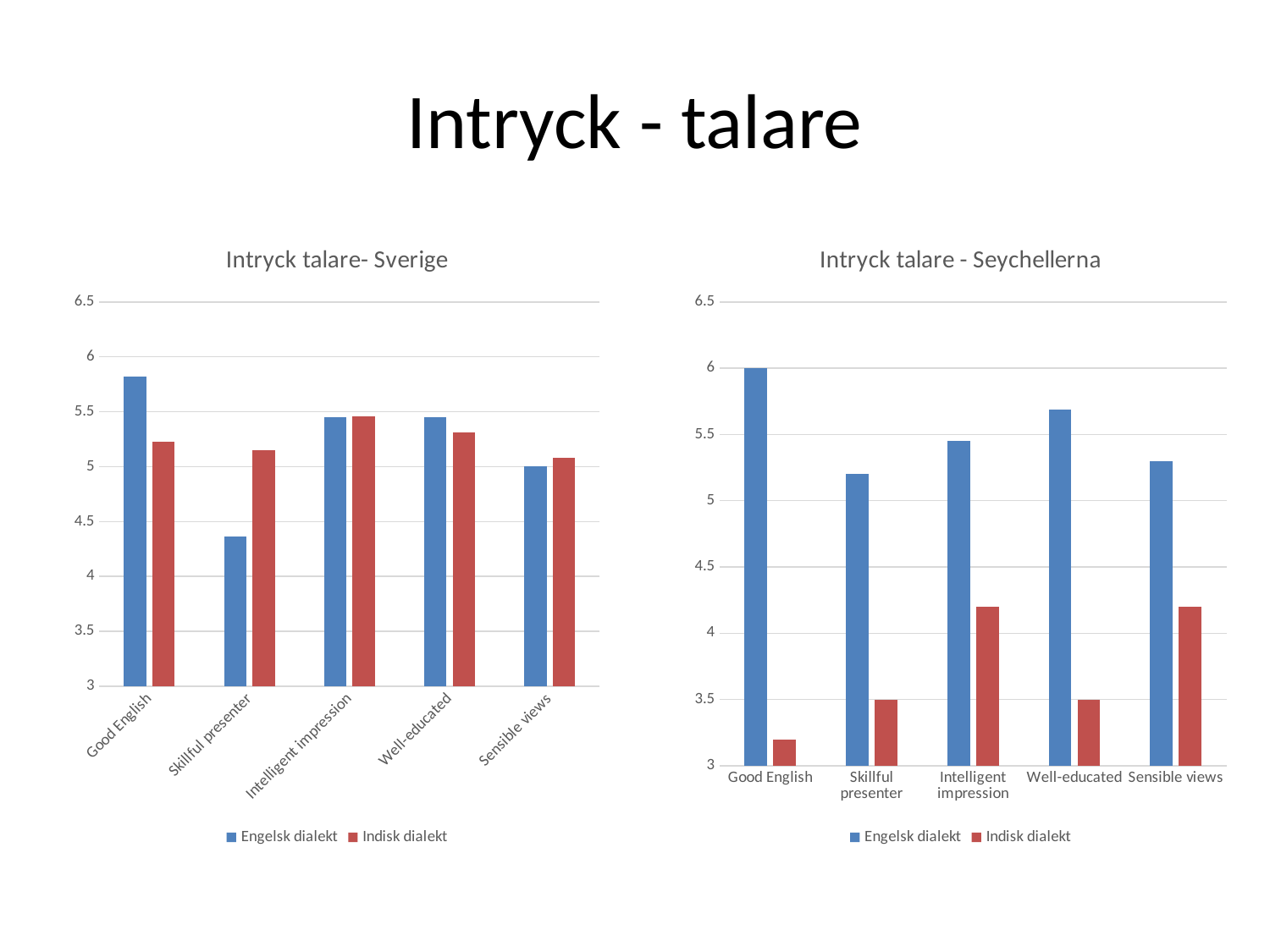
What is the title of the chart on the right side of the slide? Intryck talare - Seychellerna In the 'Intryck talare- Sverige' chart, which category has the highest value for Engelsk dialekt? Good English How many categories are shown on the x axis of the 'Intryck talare - Seychellerna' chart? 5 How many series does the legend of the 'Intryck talare- Sverige' chart list? 2 In the 'Intryck talare - Seychellerna' chart, which series has the larger value for Good English, Engelsk dialekt or Indisk dialekt? Engelsk dialekt In the 'Intryck talare - Seychellerna' chart, is the Indisk dialekt value for Well-educated greater or less than 4? less In the 'Intryck talare- Sverige' chart, which series has the larger value for Skillful presenter, Engelsk dialekt or Indisk dialekt? Indisk dialekt In the 'Intryck talare - Seychellerna' chart, which category has the lowest value for Indisk dialekt? Good English In the 'Intryck talare- Sverige' chart, is the Engelsk dialekt value for Skillful presenter greater or less than 4.5? less In the 'Intryck talare- Sverige' chart, which category has the lowest value for Engelsk dialekt? Skillful presenter What kind of chart is the 'Intryck talare- Sverige' chart? bar chart In the 'Intryck talare - Seychellerna' chart, which category has the highest value for Engelsk dialekt? Good English